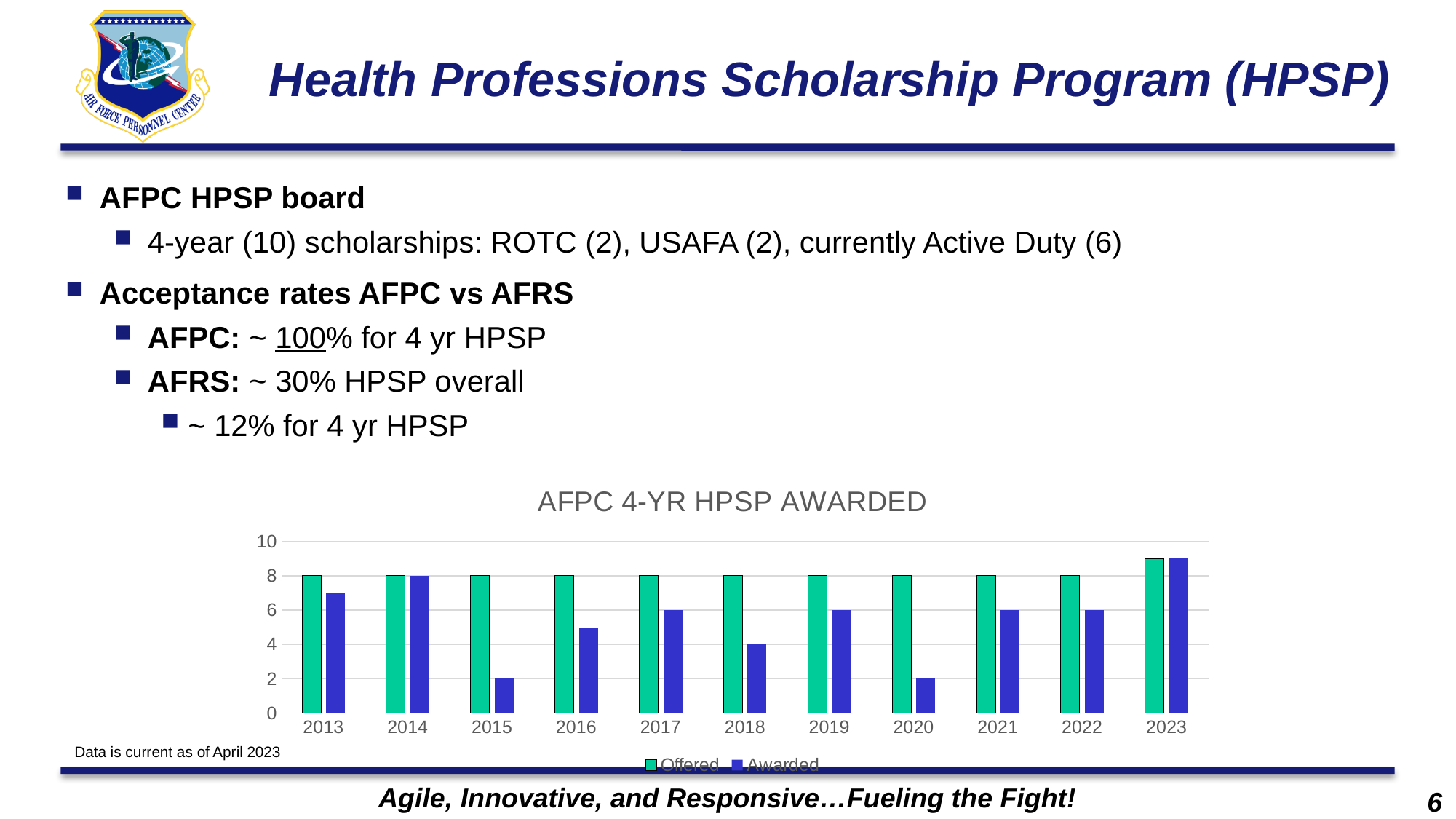
In the AFPC 4-YR HPSP AWARDED chart, which is larger: the Awarded value for 2017 or the Awarded value for 2018? 2017 In the AFPC 4-YR HPSP AWARDED chart, what is the Offered value for 2015? 8 In the AFPC 4-YR HPSP AWARDED chart, what is the difference between Offered and Awarded in 2015? 6 What type of chart is shown under the title "AFPC 4-YR HPSP AWARDED"? bar chart In the AFPC 4-YR HPSP AWARDED chart, what is the Awarded value for 2014? 8 How many series does the legend of the AFPC 4-YR HPSP AWARDED chart list? 2 In the AFPC 4-YR HPSP AWARDED chart, is the Offered value for 2023 greater or less than 8? greater In the AFPC 4-YR HPSP AWARDED chart, what is the Awarded value for 2018? 4 In the AFPC 4-YR HPSP AWARDED chart, which year has the highest Awarded value? 2023 In the AFPC 4-YR HPSP AWARDED chart, is the Awarded value for 2013 greater or less than 6? greater How many years are shown on the x axis of the AFPC 4-YR HPSP AWARDED chart? 11 In the AFPC 4-YR HPSP AWARDED chart, what is the Awarded value for 2020? 2